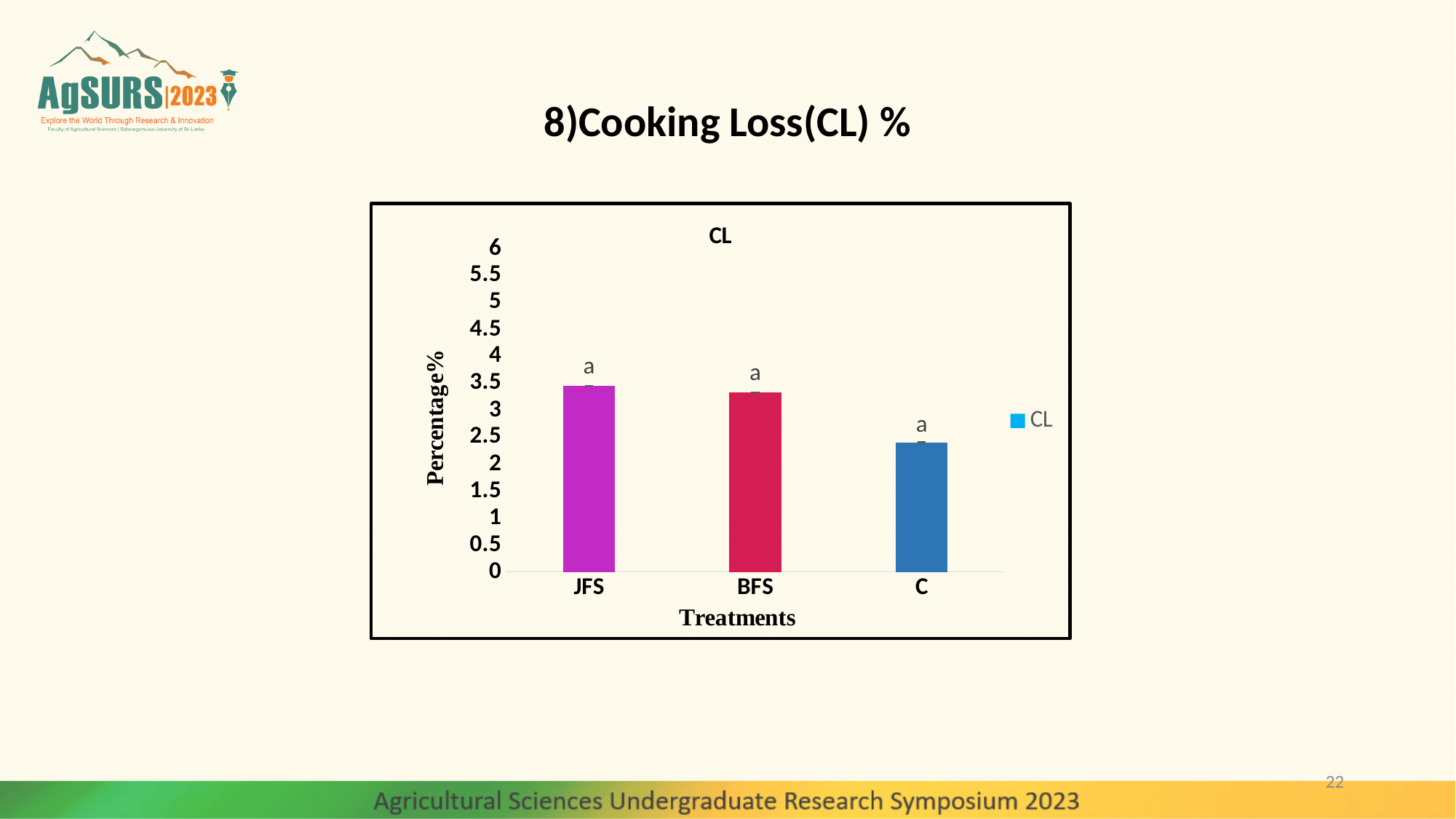
How many treatments are plotted on the x axis of the chart? 3 Is the value for BFS greater or less than 4? less What is the title shown at the top of the chart? CL Is the value for C greater or less than 2? greater Is the value for C greater or less than 3? less What is the label of the x axis of the chart? Treatments How many series does the chart's legend list? 1 Which has a higher cooking loss value, JFS or C? JFS Which has a higher cooking loss value, BFS or C? BFS What kind of chart is shown on the slide? bar chart Which treatment has the lowest cooking loss percentage? C